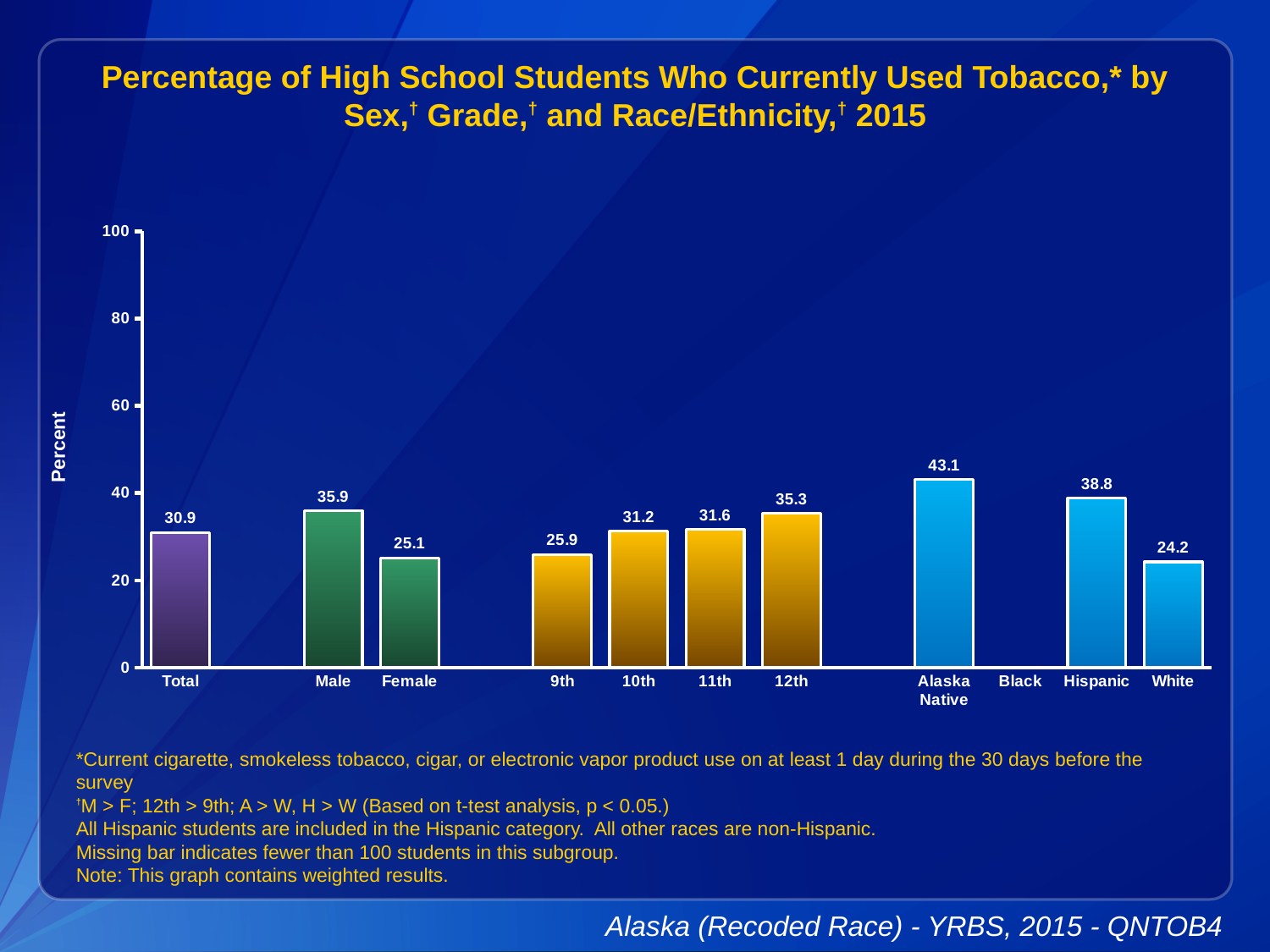
What kind of chart is shown? bar chart Which category has no bar shown? Black What is the value for Hispanic? 38.8 What is the value for Total? 30.9 Is the value for Alaska Native greater or less than 40? greater Do the values rise or fall from 9th grade to 12th grade? rise Which is larger, the value for 9th grade or the value for 12th grade? 12th What is the value for 12th grade? 35.3 What is the value for Female? 25.1 Which category has the highest value? Alaska Native Which category has the lowest value among the bars shown? White What is the difference between the Male and Female values? 10.8